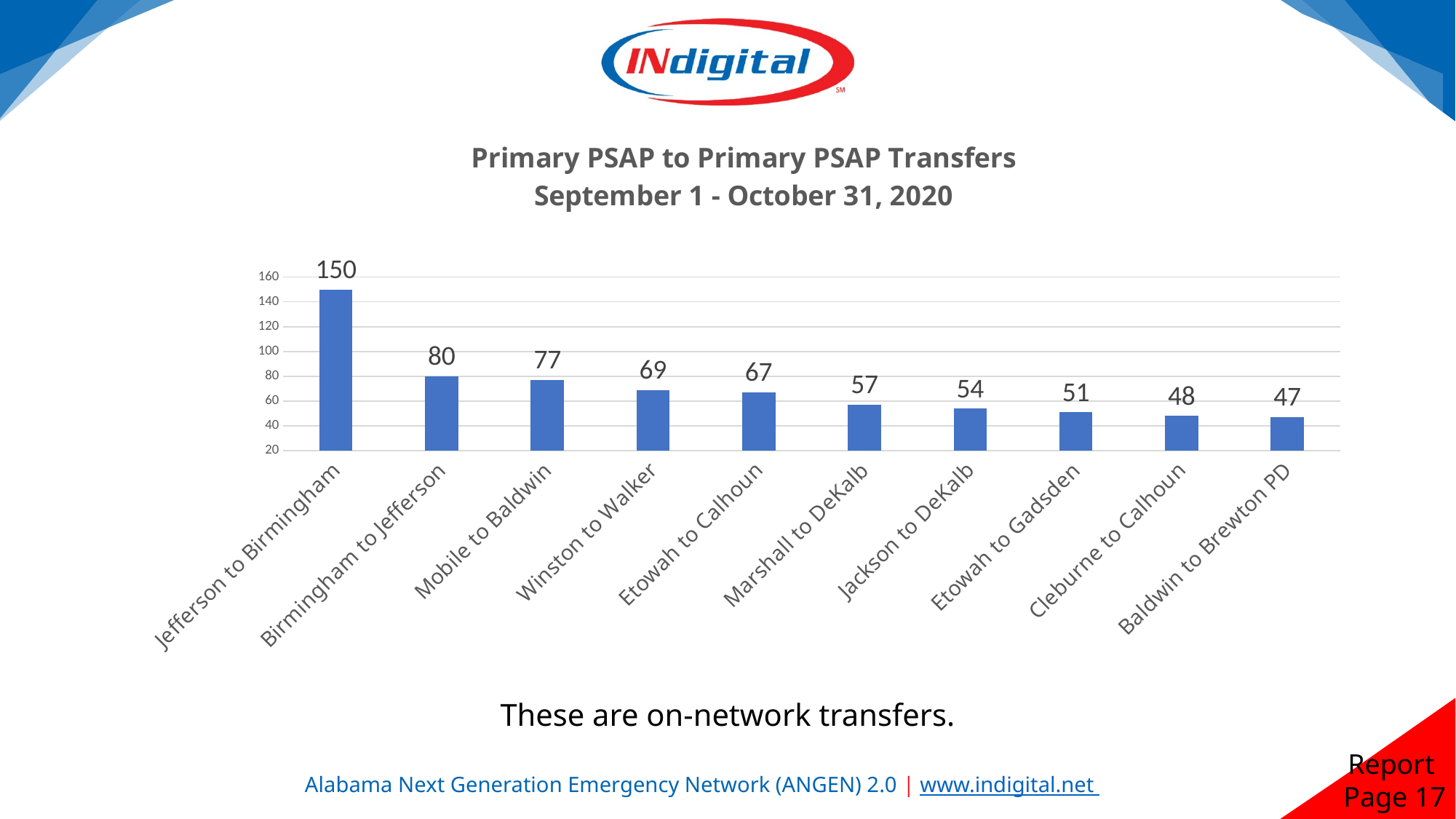
Which category has the lowest value? Baldwin to Brewton PD What is the value for Etowah to Gadsden? 51 Is the value for Birmingham to Jefferson greater or less than 100? less What kind of chart is shown on the slide? bar chart Which category has the highest value? Jefferson to Birmingham Which is larger, Marshall to DeKalb or Jackson to DeKalb? Marshall to DeKalb What is the value for Mobile to Baldwin? 77 What is the difference between Jefferson to Birmingham and Birmingham to Jefferson? 70 How many categories are shown in the chart? 10 What is the difference between Winston to Walker and Etowah to Calhoun? 2 What is the value for Jefferson to Birmingham? 150 What is the title of the chart? Primary PSAP to Primary PSAP Transfers September 1 - October 31, 2020